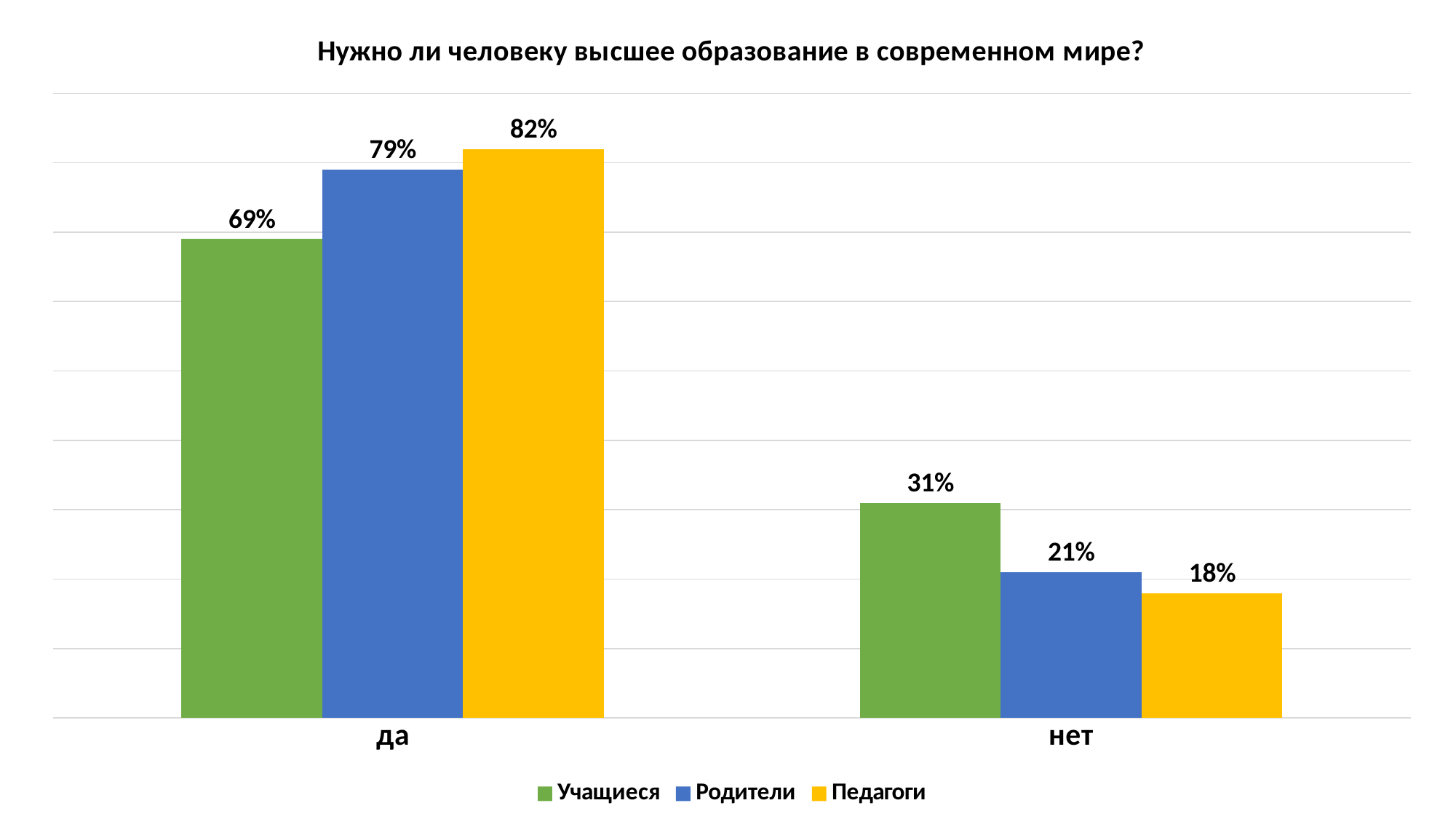
What kind of chart is shown on the slide? Bar chart What is the difference between the Учащиеся and Родители values for "нет"? 10% How many series does the legend list? 3 What percentage of Родители answered "да"? 79% Which group has the highest value for "да"? Педагоги What percentage of Педагоги answered "нет"? 18% What is the title of the chart? Нужно ли человеку высшее образование в современном мире? How many categories are shown on the x axis? 2 What percentage of Учащиеся answered "да"? 69% Which group has the lowest value for "нет"? Педагоги What is the difference between the Педагоги and Учащиеся values for "да"? 13% Which is larger: the Родители value for "нет" or the Педагоги value for "нет"? Родители